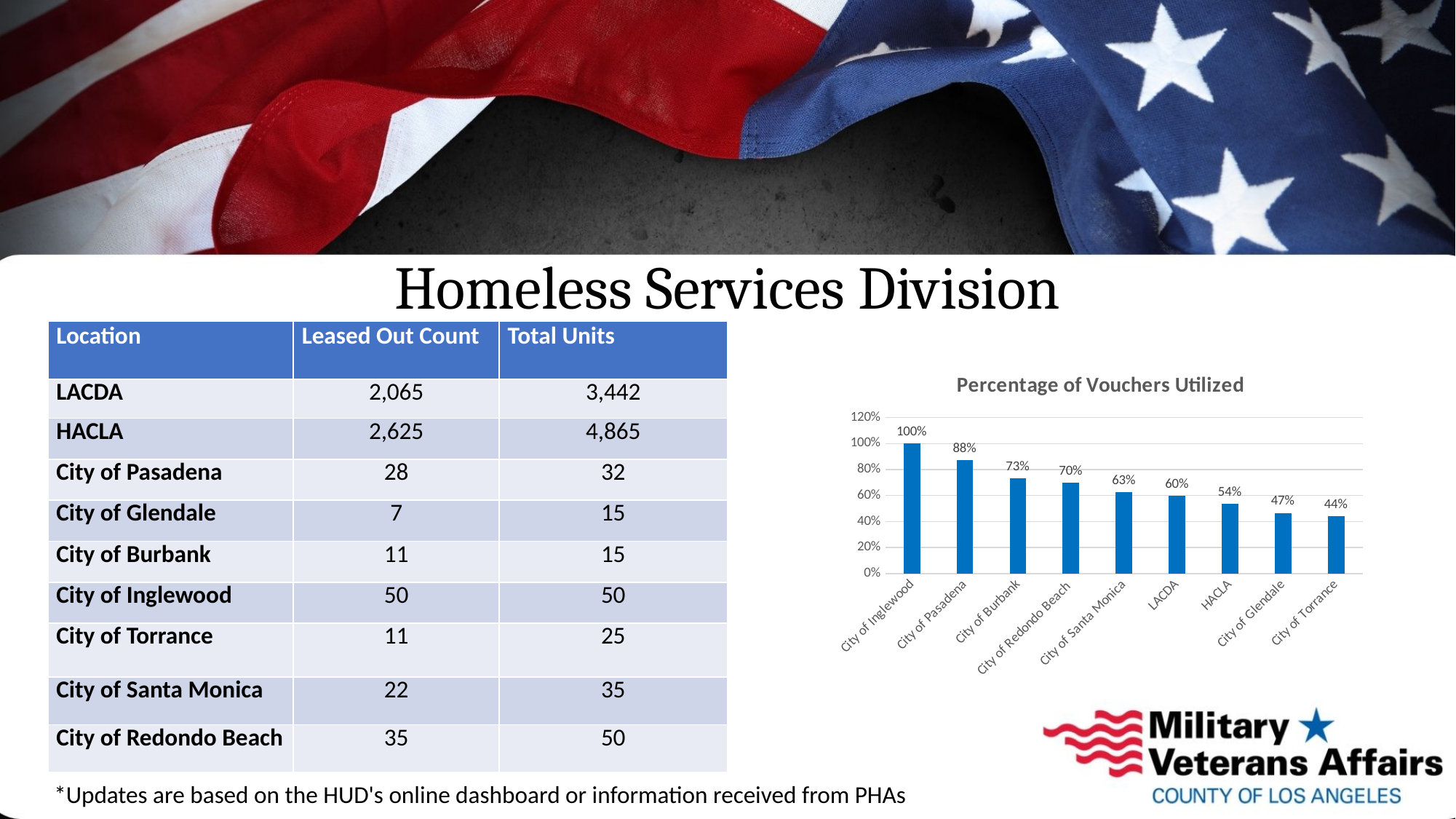
What is the percentage of vouchers utilized for HACLA? 54% What type of chart is shown on the slide? bar chart How many locations are shown in the chart? 9 Which location has the highest percentage of vouchers utilized? City of Inglewood What is the difference in percentage of vouchers utilized between City of Pasadena and City of Glendale? 41% What is the title of the chart? Percentage of Vouchers Utilized What is the percentage of vouchers utilized for City of Torrance? 44% Which has a higher percentage of vouchers utilized, LACDA or City of Santa Monica? City of Santa Monica What is the percentage of vouchers utilized for City of Burbank? 73% Which location has the lowest percentage of vouchers utilized? City of Torrance Is the value for City of Redondo Beach greater or less than 80%? less Do the values rise or fall from left to right along the x axis? fall